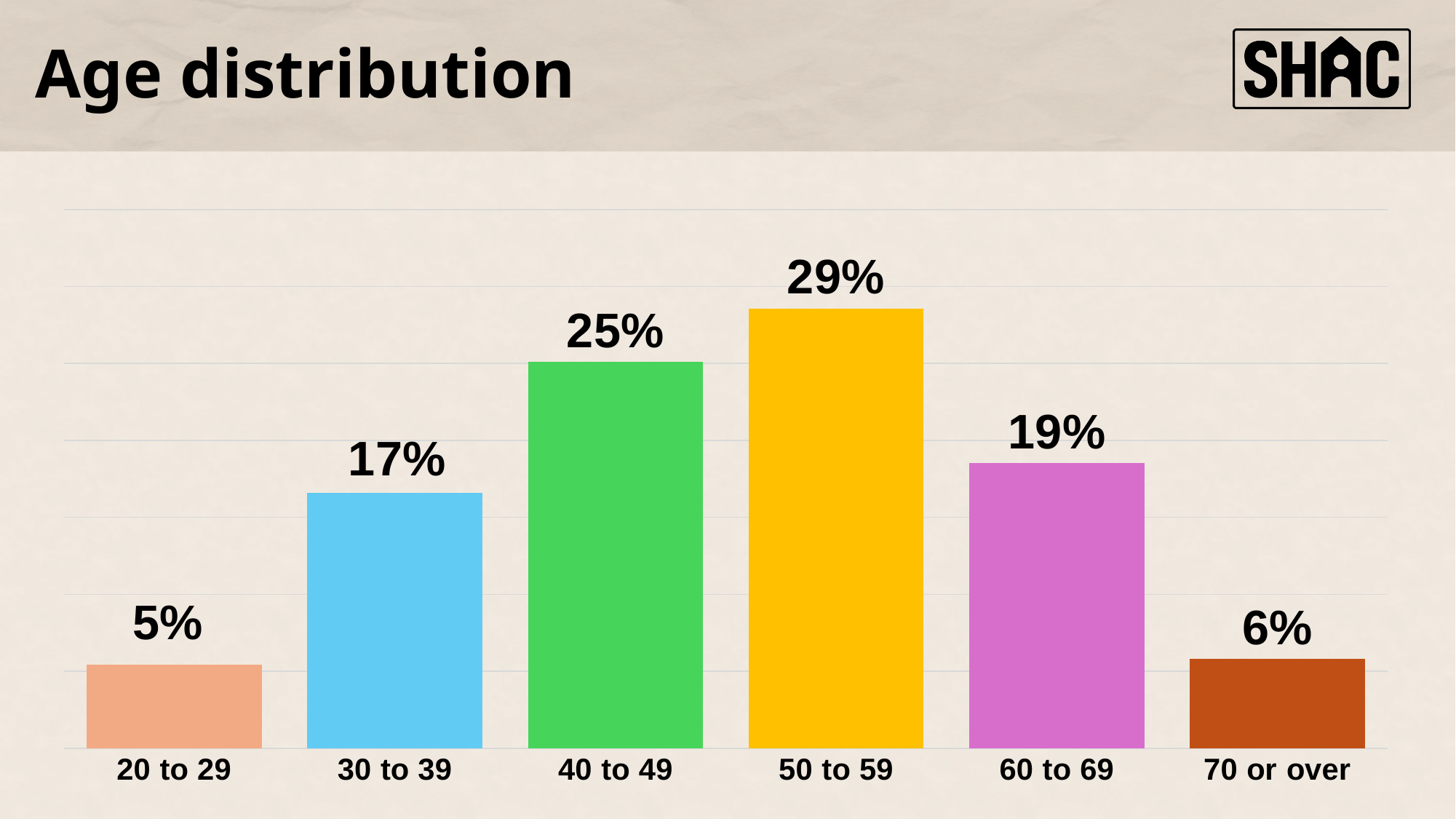
What is the title of the slide? Age distribution Which age group has the lowest value? 20 to 29 What is the difference between the values for 50 to 59 and 40 to 49? 4% Do the values rise or fall from 20 to 29 through 50 to 59? rise What kind of chart is shown on the slide? bar chart Which age group has the highest value? 50 to 59 What is the value for the 60 to 69 age group? 19% What is the difference between the values for 30 to 39 and 70 or over? 11% How many age groups are shown in the chart? 6 What is the value for the 20 to 29 age group? 5% Which is larger, the value for 30 to 39 or the value for 60 to 69? 60 to 69 What is the value for the 50 to 59 age group? 29%